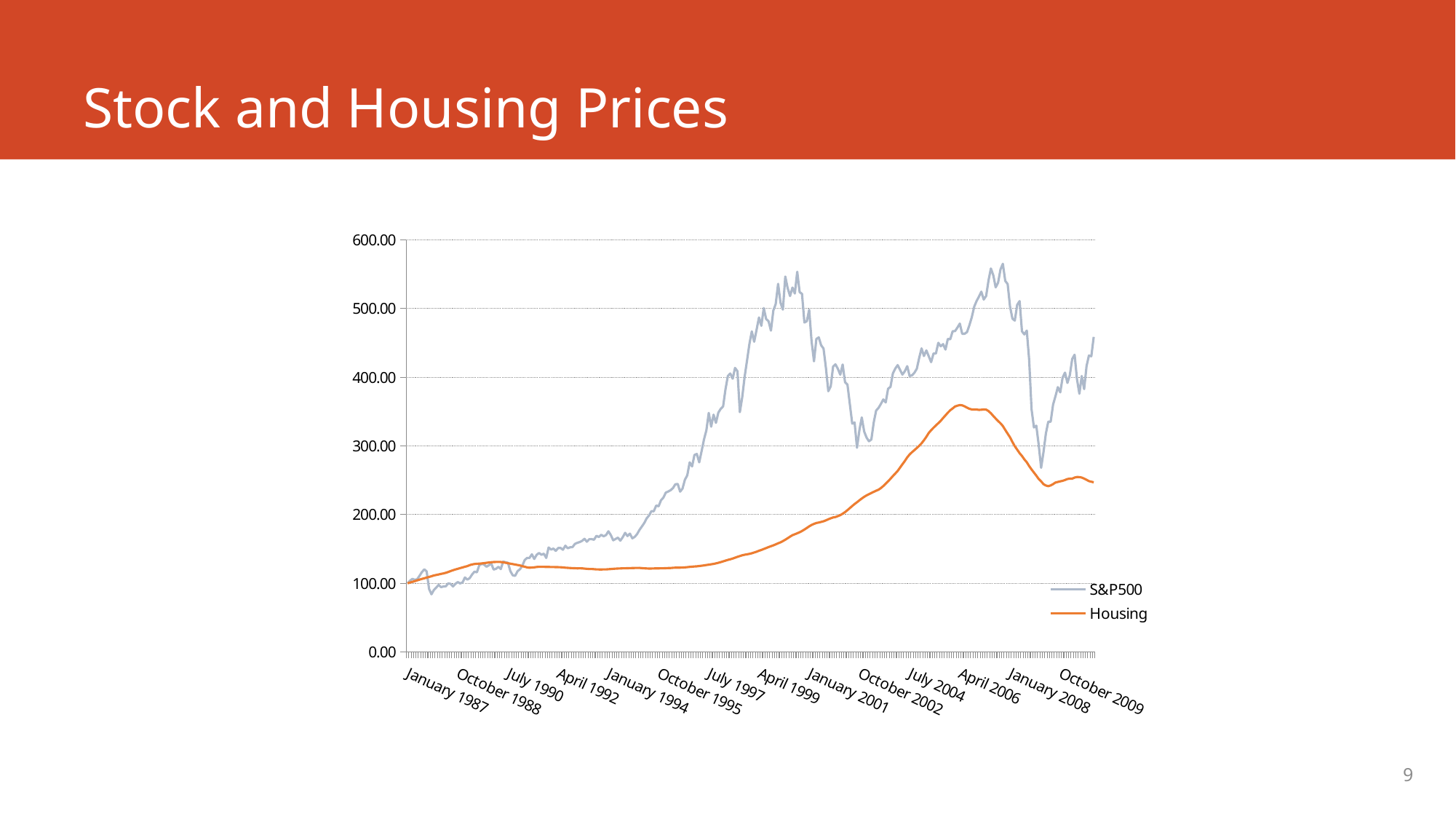
What is the title of the slide containing the chart? Stock and Housing Prices What are the two series named in the legend? S&P500 and Housing Is the value of the Housing series at October 2009 greater or less than 300? less Is the peak value of the S&P500 series around April 1999 greater or less than 500? greater How many series does the legend list? 2 Which series reaches the highest value on the chart? S&P500 What kind of chart is shown on the slide? Line chart Is the peak value of the Housing series around April 2006 greater or less than 400? less How many date labels are shown along the x axis? 14 Does the Housing series rise or fall between January 1987 and April 2006? rise At April 2006, which series has the larger value, S&P500 or Housing? S&P500